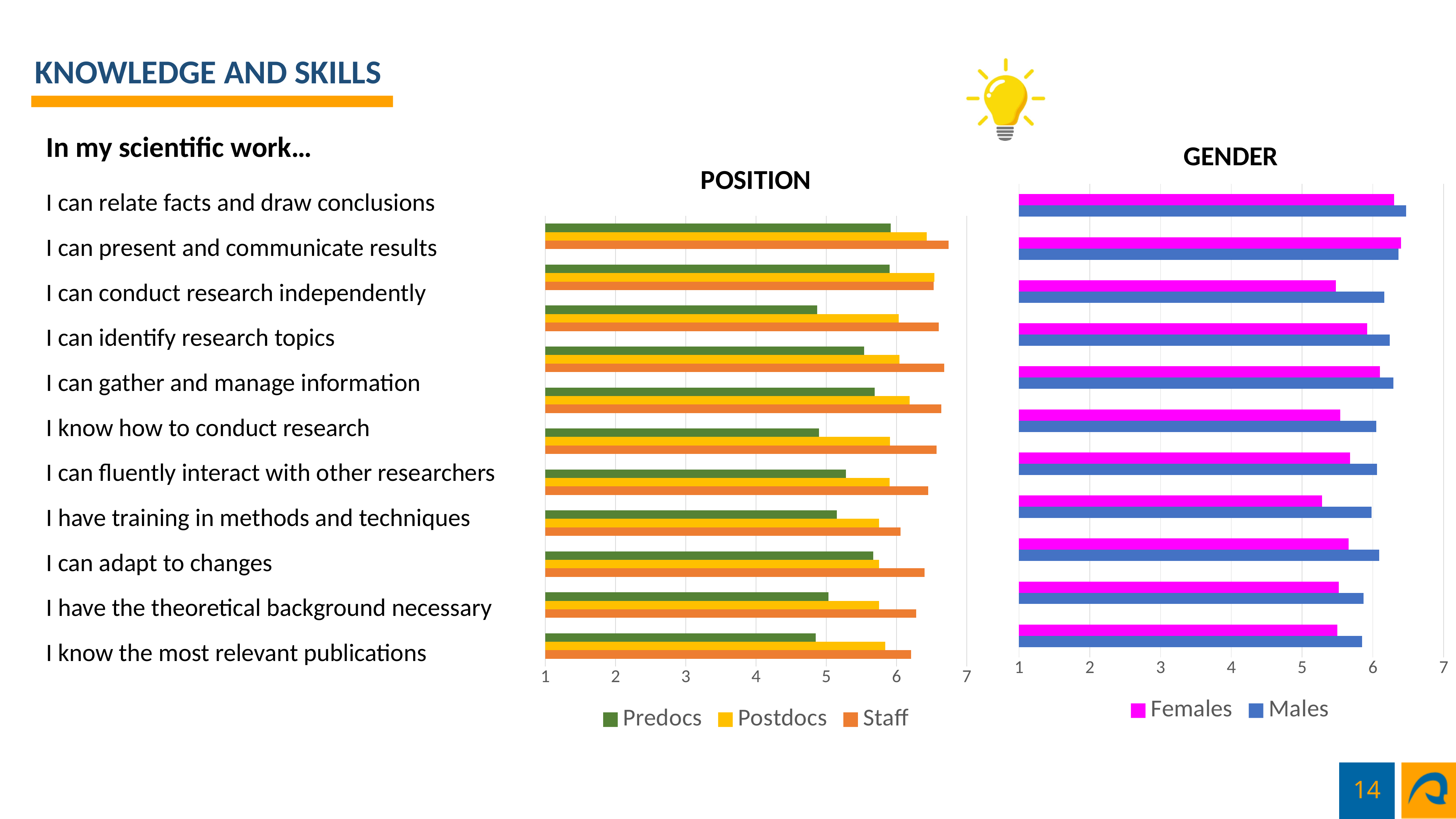
In the GENDER chart, is the Females value for "I have training in methods and techniques" greater or less than 6? less What kind of chart is the POSITION chart? bar chart In the GENDER chart, for "I can conduct research independently", which is larger: Males or Females? Males How many statements (categories) are plotted in the POSITION chart? 11 In the POSITION chart, is the Predocs value for "I can relate facts and draw conclusions" greater or less than 5? greater In the POSITION chart, which series has the highest value for "I can relate facts and draw conclusions"? Staff In the GENDER chart, what colour are the Females bars? magenta (pink) How many series does the legend of the GENDER chart list? 2 In the POSITION chart, for "I can conduct research independently", which is larger: the Staff value or the Predocs value? Staff In the POSITION chart, is the Staff value for "I can relate facts and draw conclusions" greater or less than 6? greater How many series does the legend of the POSITION chart list? 3